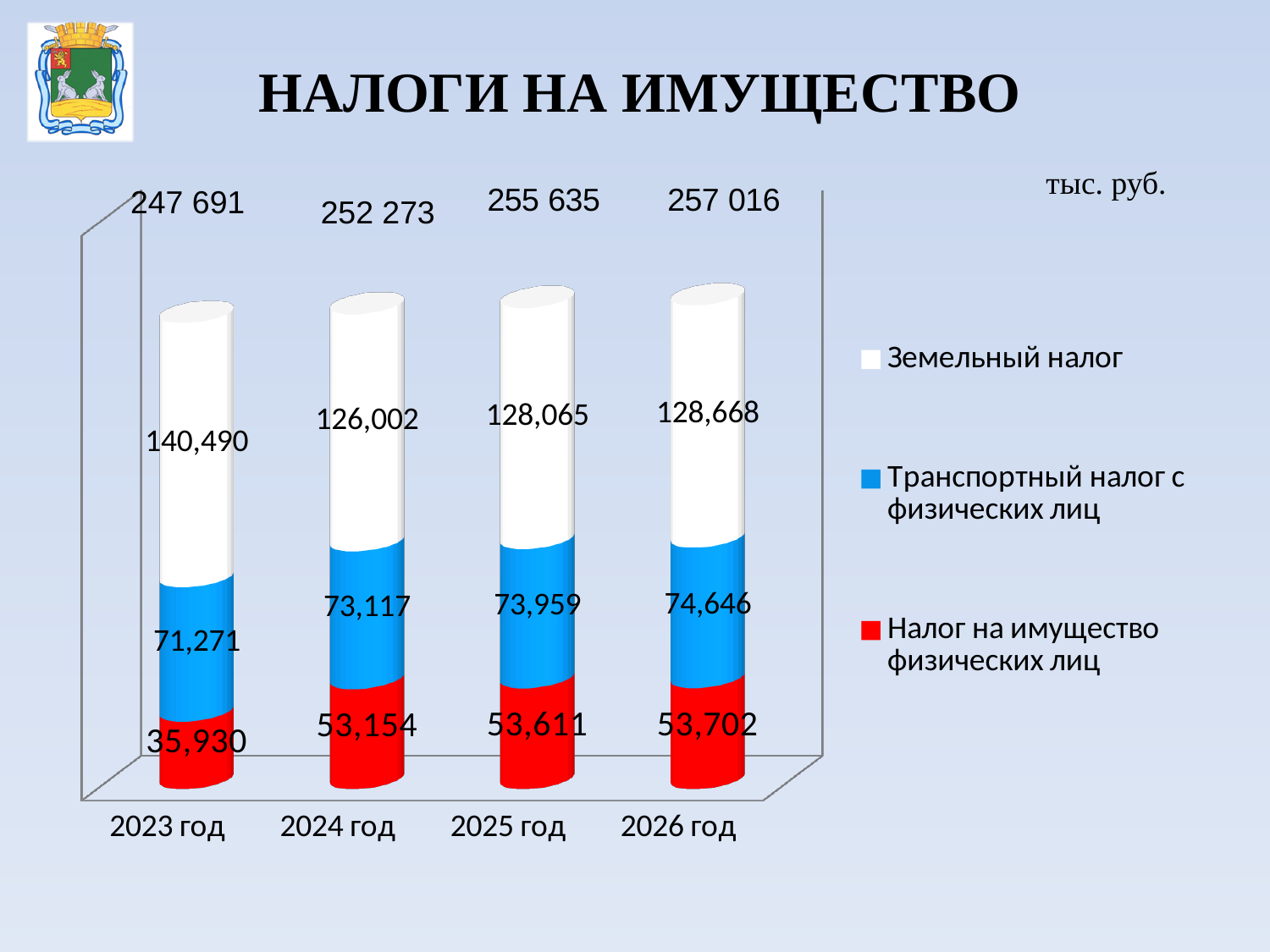
Which year has the lowest value of Налог на имущество физических лиц? 2023 год Which year has the highest value of Земельный налог? 2023 год Which is larger: Земельный налог for 2024 год or Земельный налог for 2026 год? 2026 год What is the value of Налог на имущество физических лиц for 2024 год? 53,154 What is the difference between the Транспортный налог с физических лиц values for 2026 год and 2025 год? 687 What is the total shown above the stacked bar for 2025 год? 255 635 How many series does the legend list? 3 What kind of chart is shown on the slide? Stacked bar chart Do the bar totals rise or fall from 2023 год to 2026 год? Rise What is the value of Транспортный налог с физических лиц for 2026 год? 74,646 How many years are shown on the x axis? 4 What is the value of Земельный налог for 2023 год? 140,490